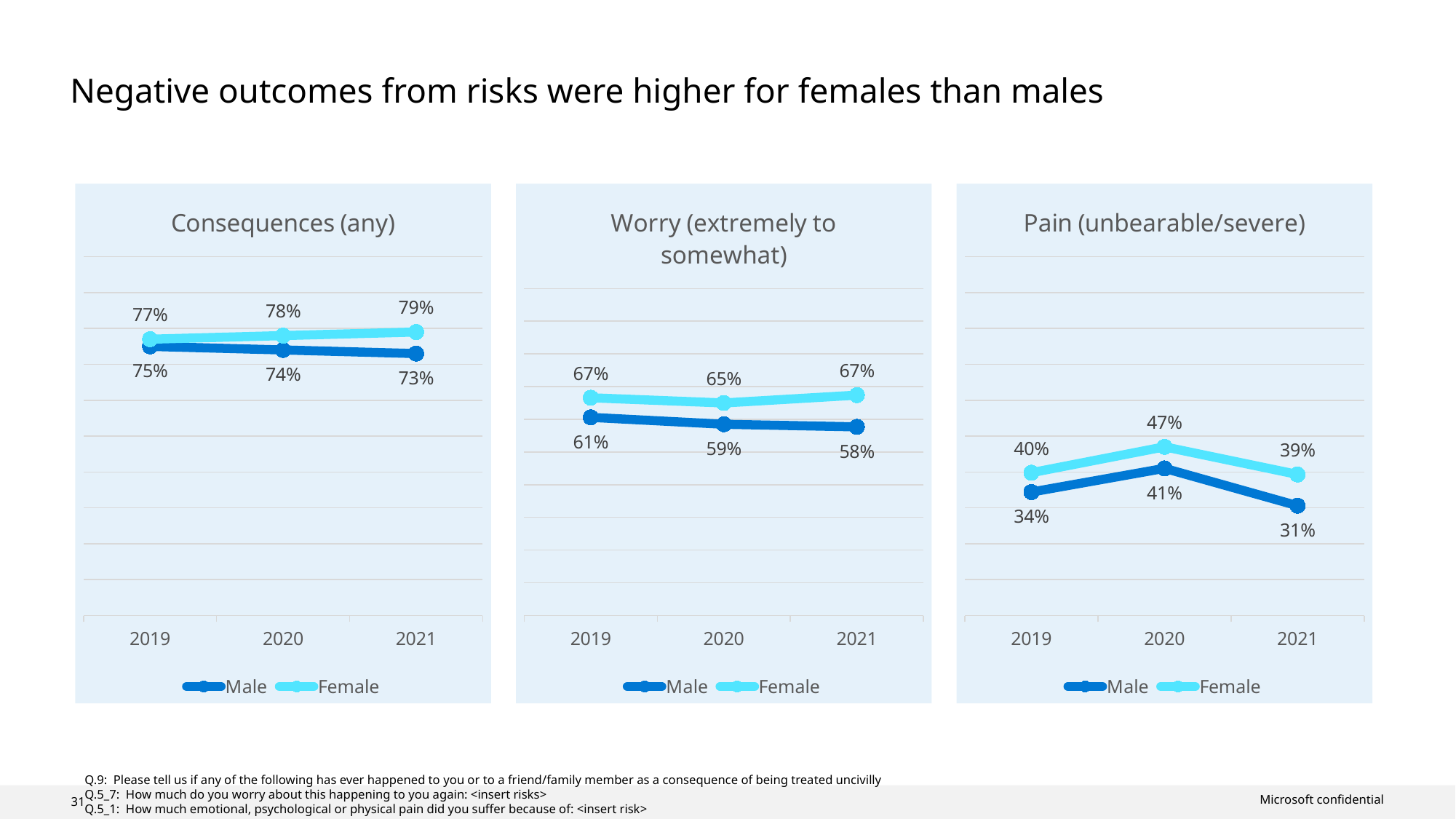
In the 'Pain (unbearable/severe)' chart, which year has the lowest Male value? 2021 What kind of chart is the 'Worry (extremely to somewhat)' chart? Line chart How many series does the legend of the 'Pain (unbearable/severe)' chart list? 2 In the 'Consequences (any)' chart, what is the difference between the Female and Male values in 2019? 2% In the 'Worry (extremely to somewhat)' chart, which year has the lowest Female value? 2020 In the 'Pain (unbearable/severe)' chart, what is the Female value for 2020? 47% In the 'Pain (unbearable/severe)' chart, what is the difference between the Female and Male values in 2021? 8% In the 'Consequences (any)' chart, does the Male value rise or fall from 2019 to 2021? Fall In the 'Consequences (any)' chart, what is the Female value for 2021? 79% In the 'Worry (extremely to somewhat)' chart, what is the Male value for 2021? 58% In the 'Consequences (any)' chart, what is the Male value for 2020? 74% In the 'Worry (extremely to somewhat)' chart, which is larger in 2020: the Male value or the Female value? Female